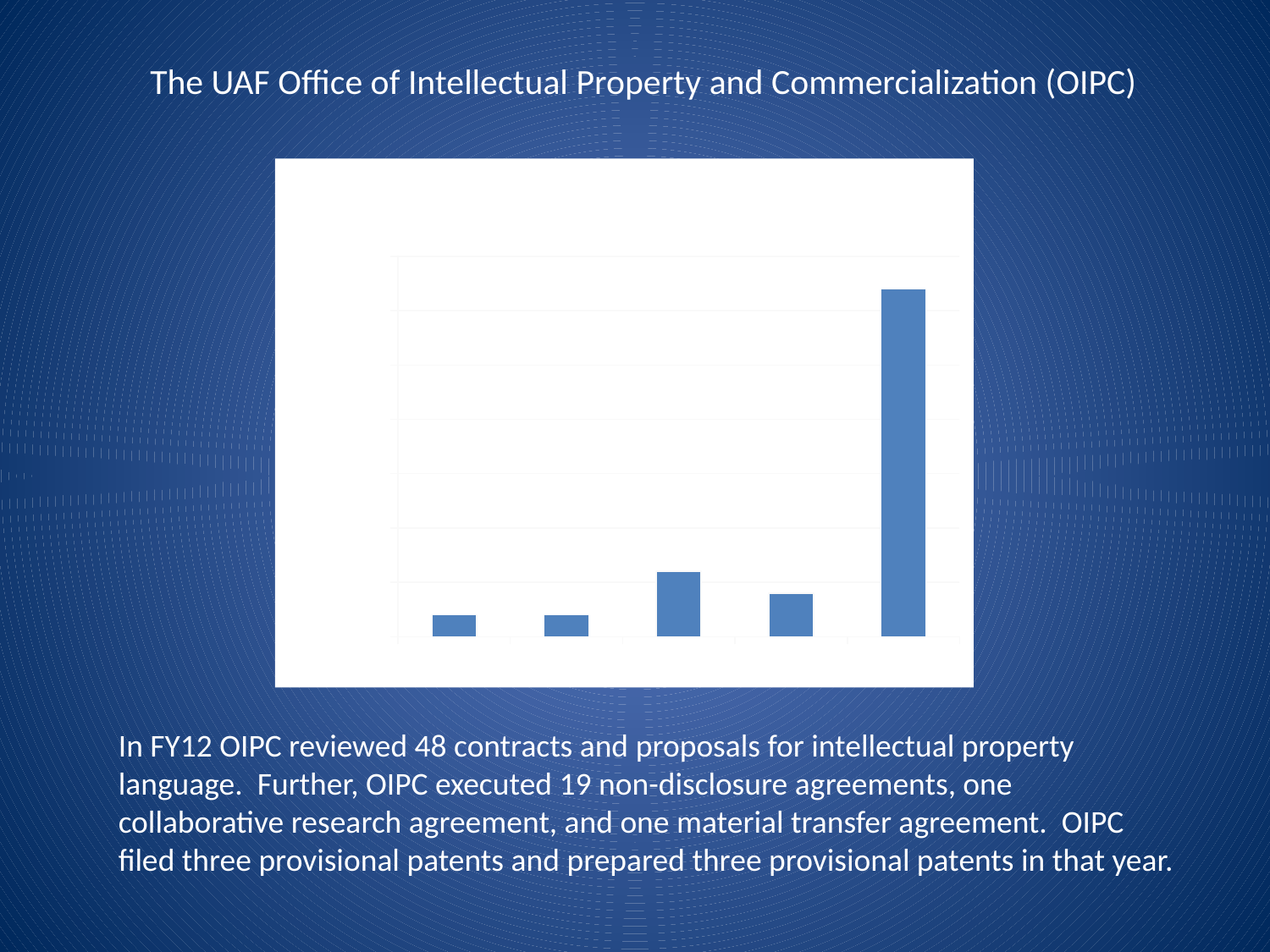
Which is taller in the chart, the third bar from the left or the fourth bar from the left? the third bar Which is taller in the chart, the rightmost bar or the third bar from the left? the rightmost bar Which bar in the chart is the tallest, counting from the left? the fifth (rightmost) bar How many bars are plotted in the chart? 5 Which is taller in the chart, the fourth bar from the left or the first bar from the left? the fourth bar What kind of chart is shown on the slide? bar chart Does the chart display a legend? No What colour are the bars in the chart? blue